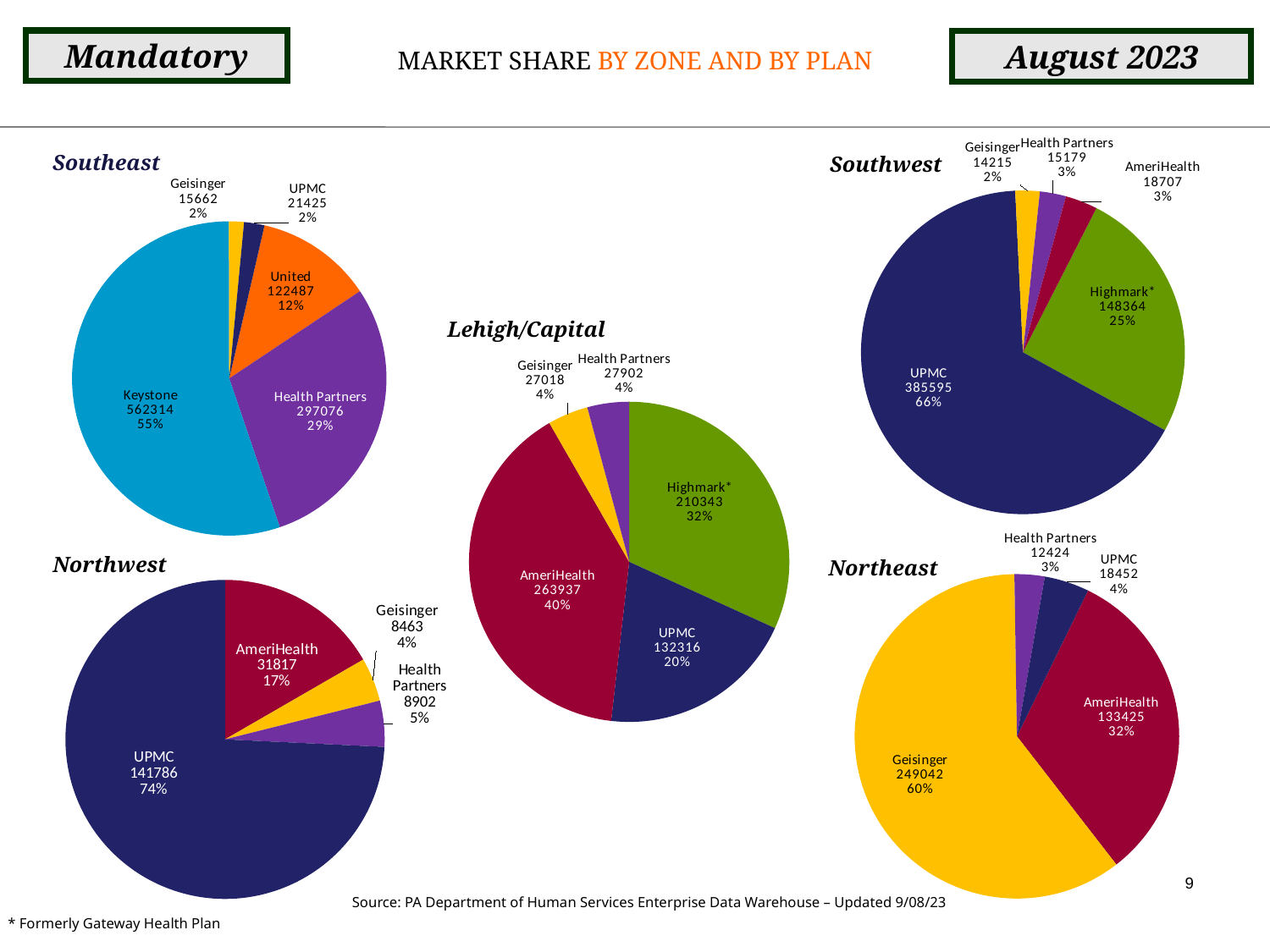
In the Lehigh/Capital pie chart, what is the value for UPMC? 132316 What kind of chart is used for the Southeast zone? Pie chart In the Lehigh/Capital pie chart, which plan has the largest slice? AmeriHealth How many slices does the Northwest pie chart have? 4 How many pie charts are shown on the slide? 5 In the Southwest pie chart, what share does UPMC hold? 66% In the Northeast pie chart, which is larger, UPMC or Health Partners? UPMC In the Southeast pie chart, what is the value for Keystone? 562314 In the Northeast pie chart, what is the difference between the Geisinger value and the AmeriHealth value? 115617 In the Northwest pie chart, what is the value for AmeriHealth? 31817 In the Southeast pie chart, what share does Health Partners hold? 29% In the Southwest pie chart, which plan has the smallest slice? Geisinger